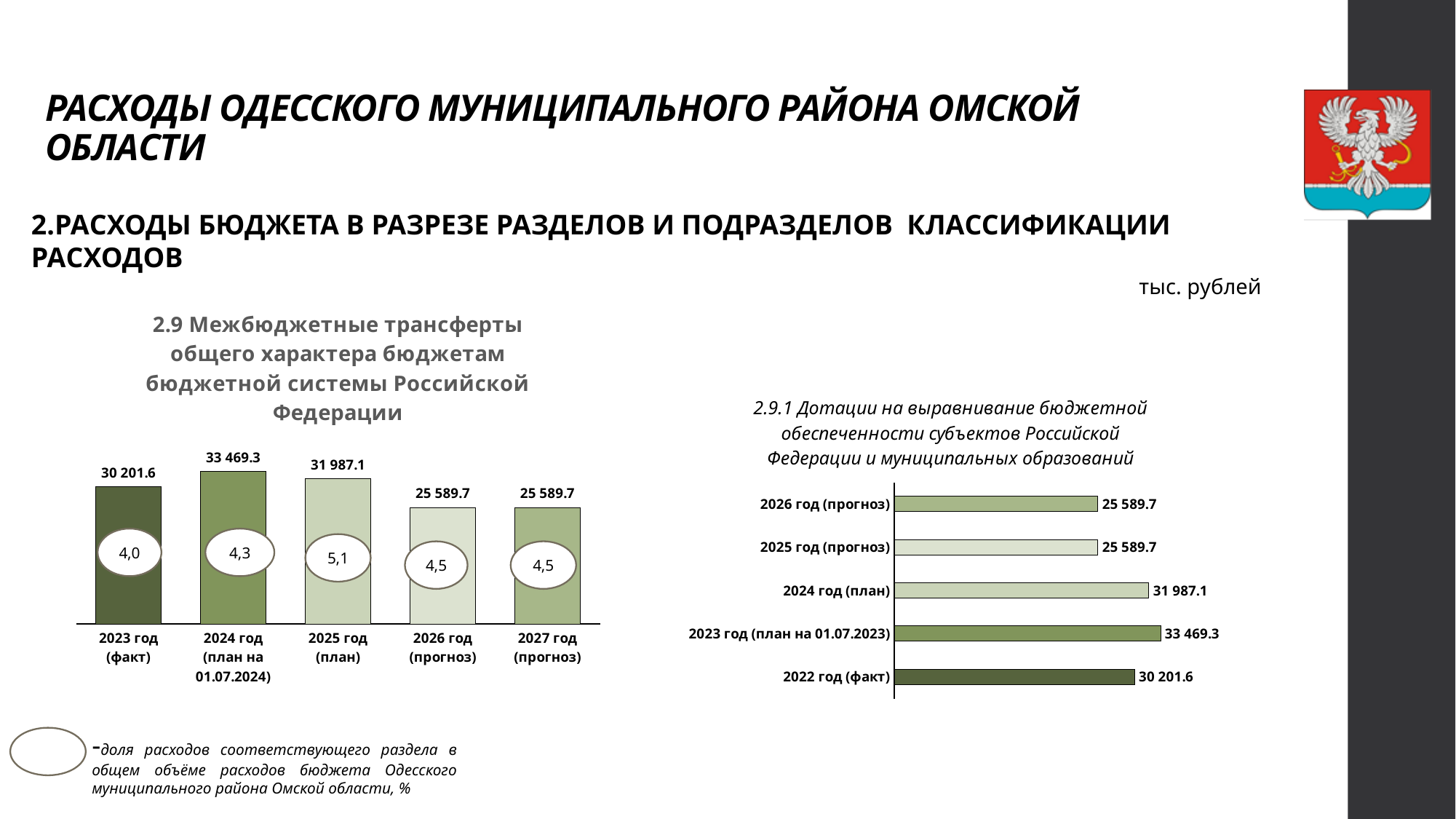
In the left chart (2.9 Межбюджетные трансферты общего характера), what is the value for 2023 год (факт)? 30 201.6 In the left chart (2.9 Межбюджетные трансферты общего характера), which category has the highest value? 2024 год (план на 01.07.2024) In the left chart (2.9 Межбюджетные трансферты общего характера), what is the difference between the values for 2024 год (план на 01.07.2024) and 2023 год (факт)? 3 267.7 In the left chart (2.9 Межбюджетные трансферты общего характера), how many bars are plotted? 5 In the left chart (2.9 Межбюджетные трансферты общего характера), what is the value for 2025 год (план)? 31 987.1 In the right chart (2.9.1 Дотации на выравнивание бюджетной обеспеченности), which is larger: the value for 2024 год (план) or 2022 год (факт)? 2024 год (план) What kind of chart is the left chart (2.9 Межбюджетные трансферты общего характера)? Bar chart In the right chart (2.9.1 Дотации на выравнивание бюджетной обеспеченности), what is the difference between the values for 2024 год (план) and 2025 год (прогноз)? 6 397.4 In the left chart (2.9 Межбюджетные трансферты общего характера), what share percentage is shown in the oval for 2025 год (план)? 5,1 In the right chart (2.9.1 Дотации на выравнивание бюджетной обеспеченности), what is the value for 2022 год (факт)? 30 201.6 In the right chart (2.9.1 Дотации на выравнивание бюджетной обеспеченности), what is the value for 2023 год (план на 01.07.2023)? 33 469.3 In the right chart (2.9.1 Дотации на выравнивание бюджетной обеспеченности), which category has the lowest value? 2025 год (прогноз) and 2026 год (прогноз), both 25 589.7